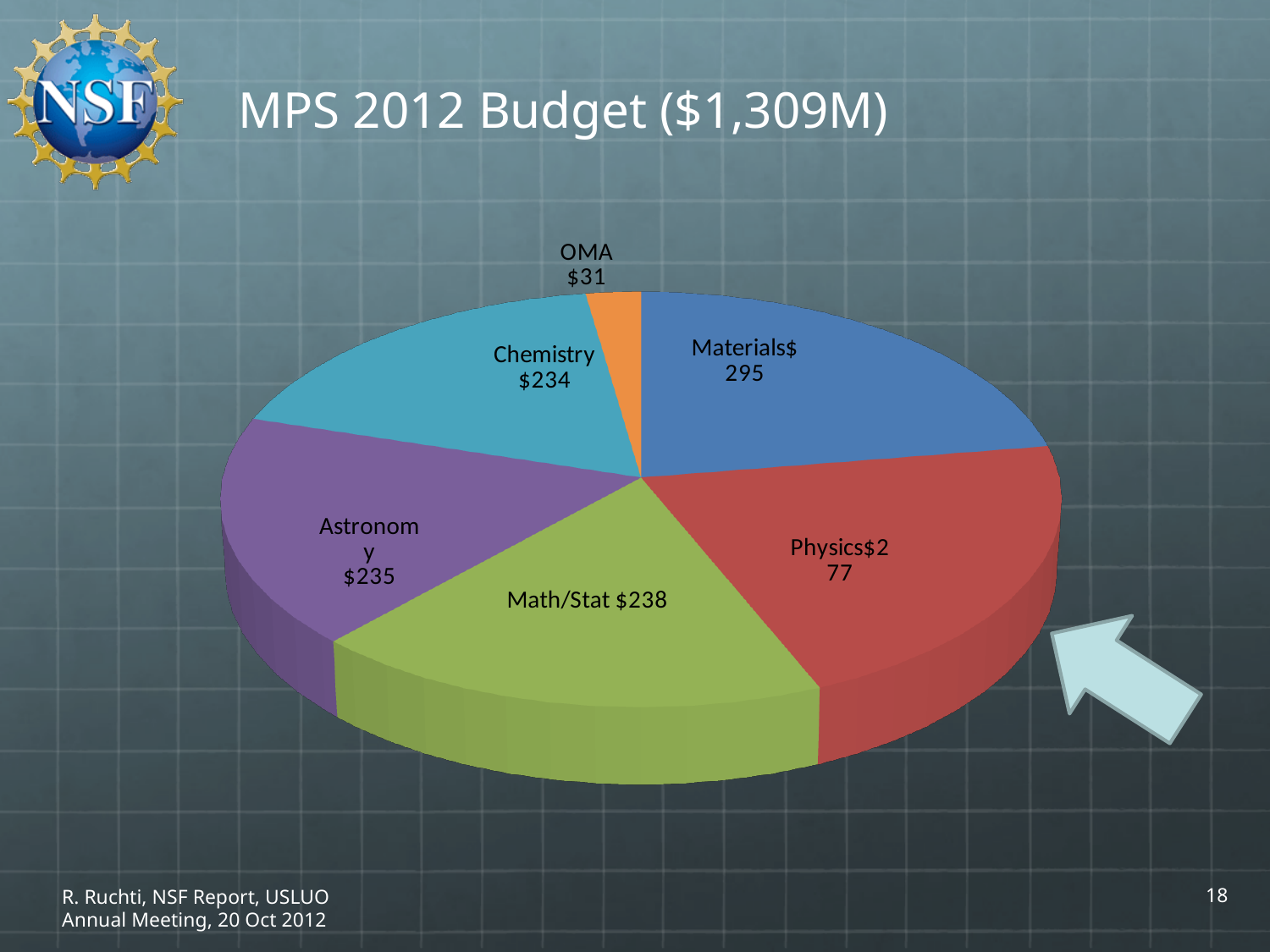
What is the value shown for OMA? $31 What is the value shown for Physics? $277 What kind of chart is shown on the slide? Pie chart Which is larger, the value for Astronomy or the value for Chemistry? Astronomy What is the difference between the Materials value and the Physics value? $18 What is the value shown for Chemistry? $234 What is the difference between the Physics value and the Math/Stat value? $39 Which category has the smallest slice of the pie? OMA How many categories are shown in the pie chart? 6 What is the value shown for Materials? $295 What is the value shown for Math/Stat? $238 Which category has the largest slice of the pie? Materials